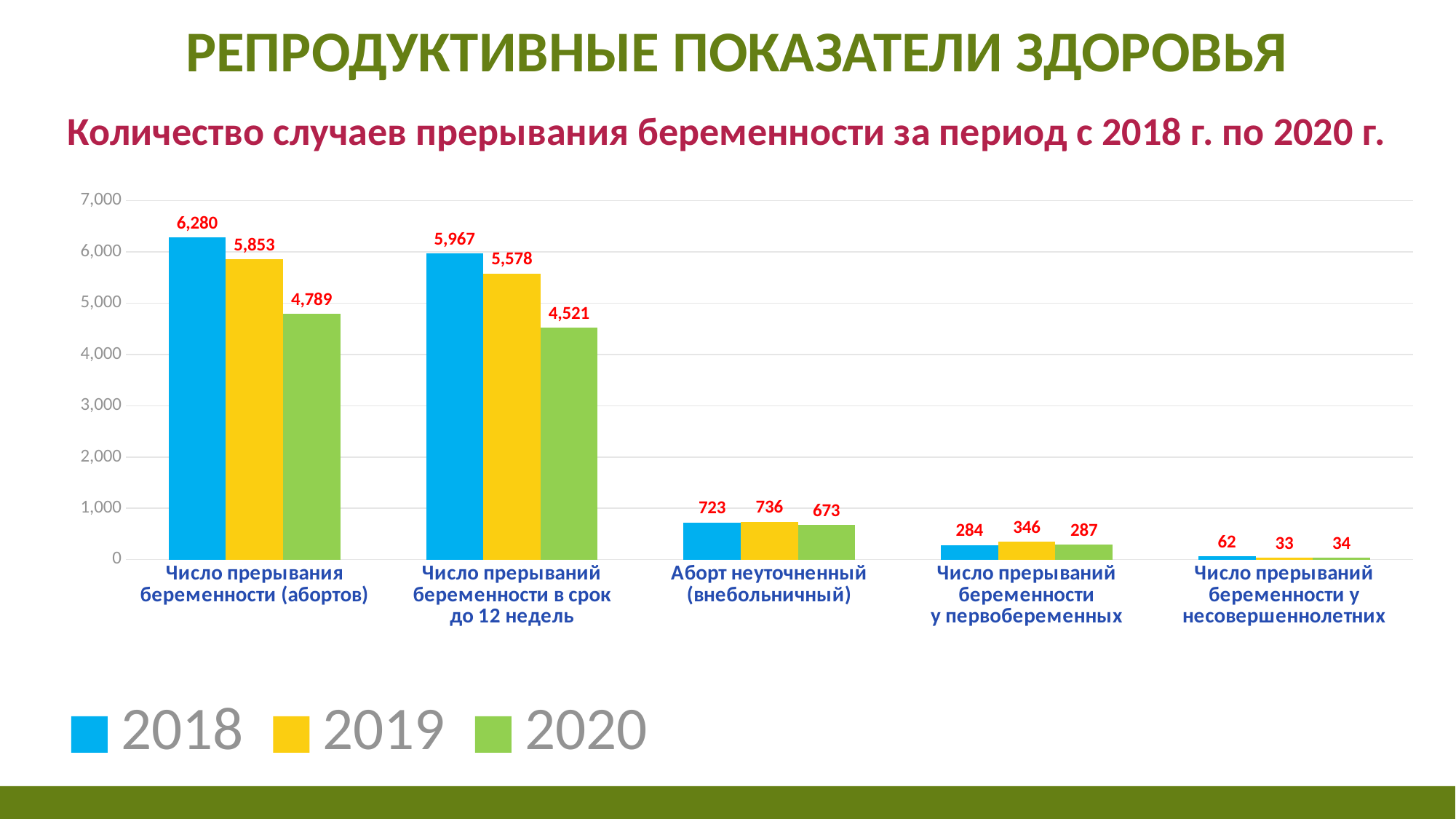
Which year has the highest value in the category "Число прерываний беременности у первобеременных"? 2019 How many series does the legend list? 3 What is the value for 2020 in the category "Число прерываний беременности у несовершеннолетних"? 34 How many categories are shown on the x axis? 5 Which is larger: the 2018 value or the 2019 value in the category "Аборт неуточненный (внебольничный)"? 2019 What is the difference between the 2018 and 2020 values in the category "Число прерывания беременности (абортов)"? 1,491 Which category has the lowest values across all three years? Число прерываний беременности у несовершеннолетних What is the value for 2018 in the category "Число прерывания беременности (абортов)"? 6,280 What is the value for 2019 in the category "Аборт неуточненный (внебольничный)"? 736 What is the value for 2020 in the category "Число прерываний беременности в срок до 12 недель"? 4,521 What kind of chart is shown on the slide? Bar chart Which colour represents the year 2020 in the legend? Green